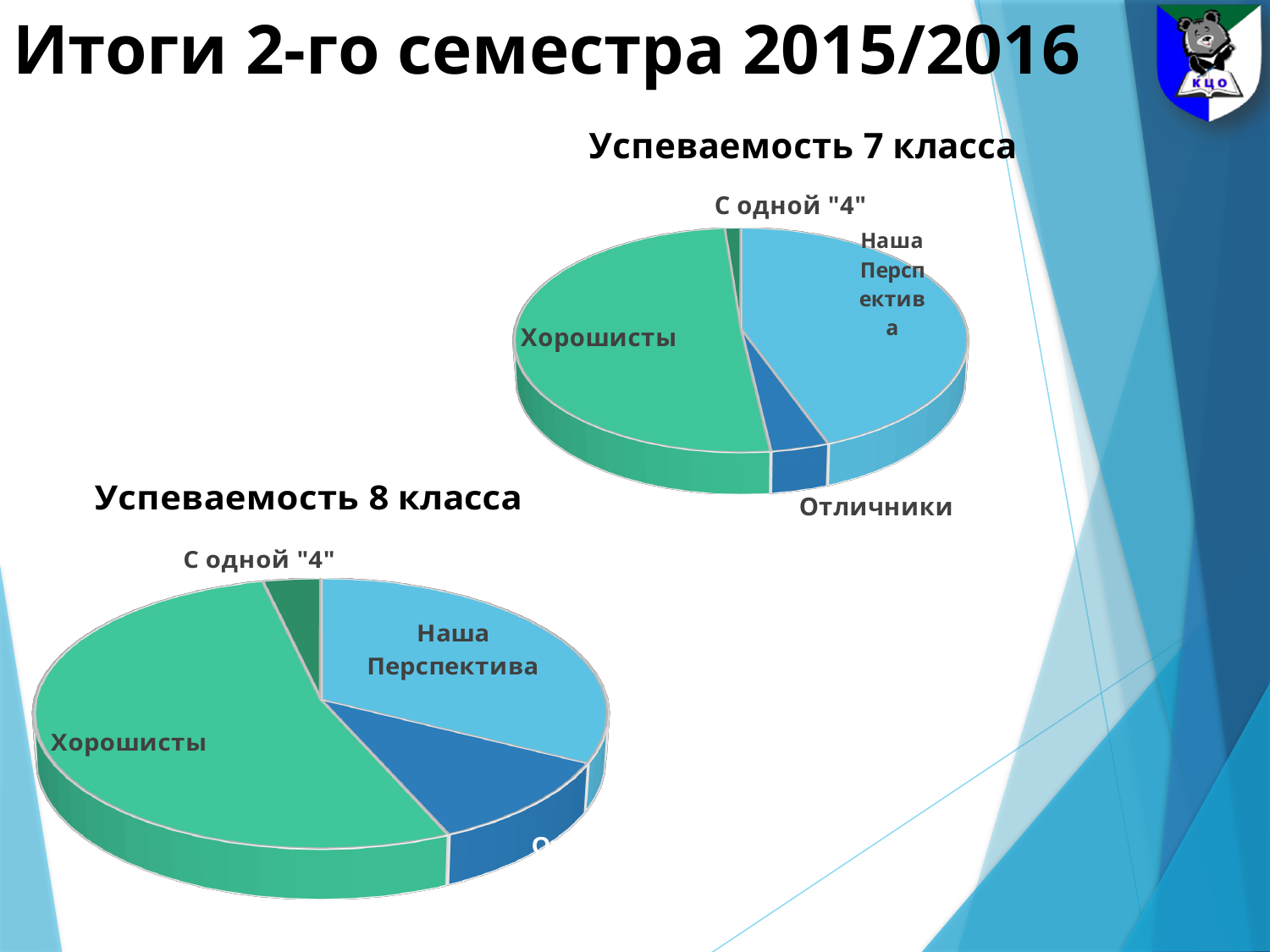
What kind of chart is "Успеваемость 7 класса"? Pie chart What kind of chart is "Успеваемость 8 класса"? Pie chart In the "Успеваемость 7 класса" chart, which slice is larger: Хорошисты or Наша Перспектива? Хорошисты In the "Успеваемость 8 класса" chart, which slice is larger: Наша Перспектива or С одной "4"? Наша Перспектива How many slices does the "Успеваемость 8 класса" pie chart have? 4 In the "Успеваемость 8 класса" chart, which category has the largest slice? Хорошисты How many slices does the "Успеваемость 7 класса" pie chart have? 4 In the "Успеваемость 7 класса" chart, which category has the largest slice? Хорошисты In the "Успеваемость 7 класса" chart, which category has the smallest slice? С одной "4" In the "Успеваемость 7 класса" chart, which slice is larger: Отличники or С одной "4"? Отличники In the "Успеваемость 8 класса" chart, which category has the smallest slice? С одной "4" What is the title of the pie chart in the lower left of the slide? Успеваемость 8 класса